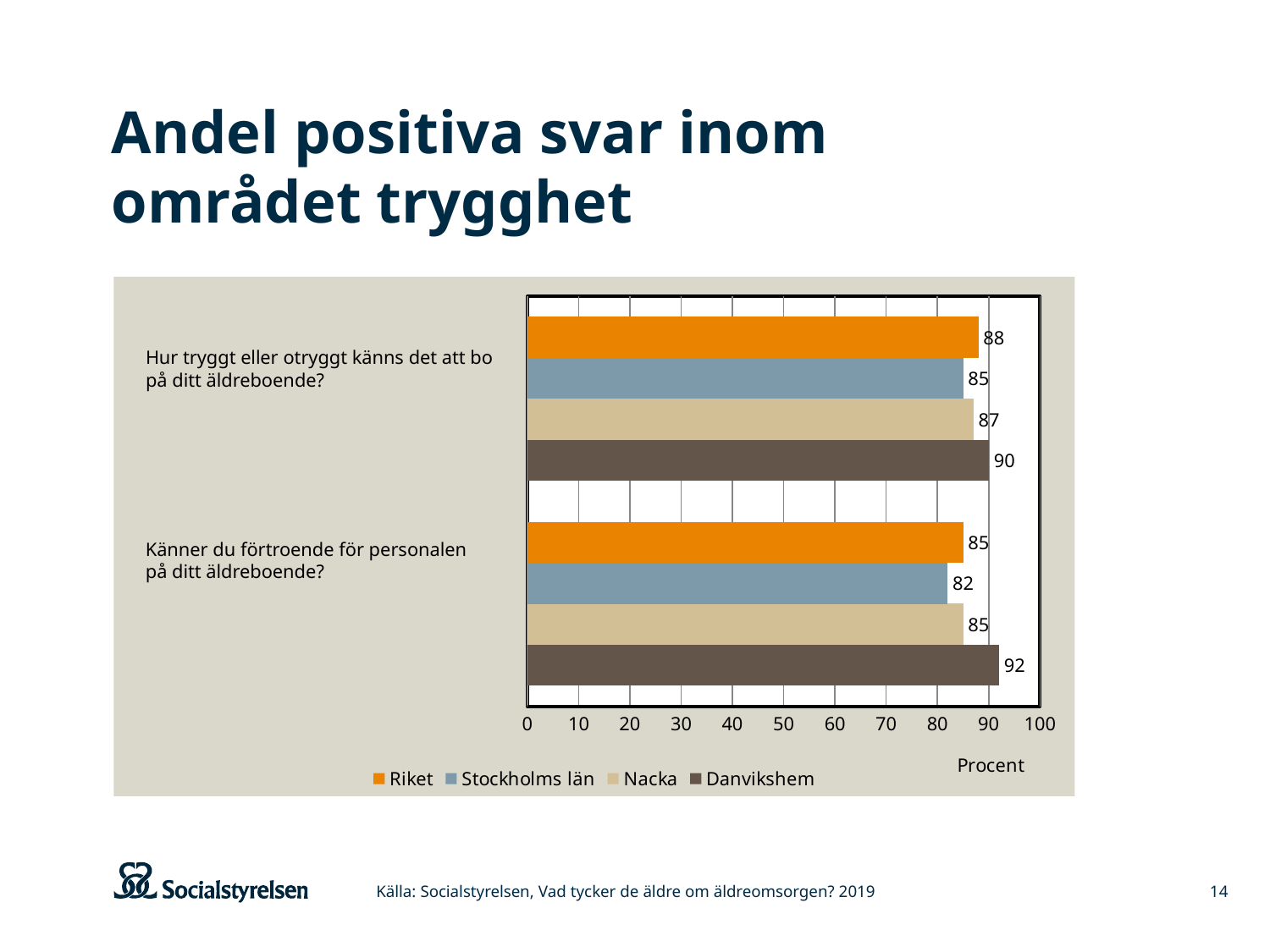
What is the value for Riket for the question "Hur tryggt eller otryggt känns det att bo på ditt äldreboende?"? 88 What is the value for Danvikshem for the question "Känner du förtroende för personalen på ditt äldreboende?"? 92 Which series has the lowest value for the question "Hur tryggt eller otryggt känns det att bo på ditt äldreboende?"? Stockholms län Which series has the highest value for the question "Känner du förtroende för personalen på ditt äldreboende?"? Danvikshem What is the value for Stockholms län for the question "Känner du förtroende för personalen på ditt äldreboende?"? 82 Is the value for Stockholms län for the question "Känner du förtroende för personalen på ditt äldreboende?" greater or less than 90? less For the question "Hur tryggt eller otryggt känns det att bo på ditt äldreboende?", which is larger: the value for Danvikshem or the value for Riket? Danvikshem What is the label of the horizontal axis? Procent How many series does the legend list? 4 What is the value for Nacka for the question "Hur tryggt eller otryggt känns det att bo på ditt äldreboende?"? 87 What kind of chart is shown on the slide? Bar chart What is the difference between the Danvikshem and Stockholms län values for the question "Känner du förtroende för personalen på ditt äldreboende?"? 10